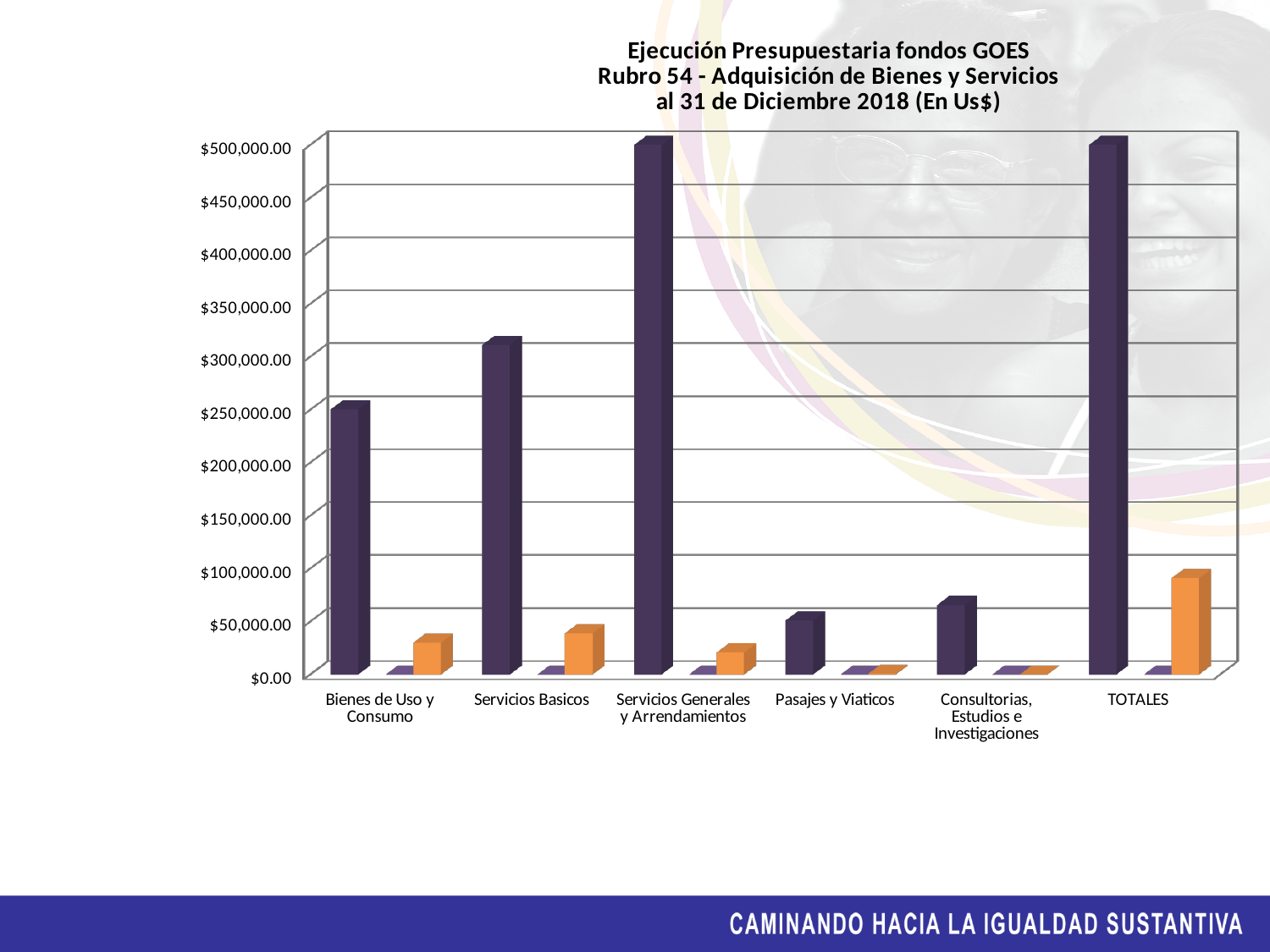
Is the value of the dark purple bar for Pasajes y Viaticos greater or less than $100,000.00? less Is the value of the dark purple bar for Bienes de Uso y Consumo greater or less than $200,000.00? greater How many categories are shown along the x axis of the chart? 6 Which has the taller dark purple bar, Bienes de Uso y Consumo or Servicios Basicos? Servicios Basicos Which has the taller orange bar, Servicios Basicos or Servicios Generales y Arrendamientos? Servicios Basicos Is the value of the dark purple bar for Servicios Basicos greater or less than $250,000.00? greater What kind of chart is shown on the slide? bar chart Which category has the lowest dark purple bar? Pasajes y Viaticos What is the highest value shown on the chart's vertical axis? $500,000.00